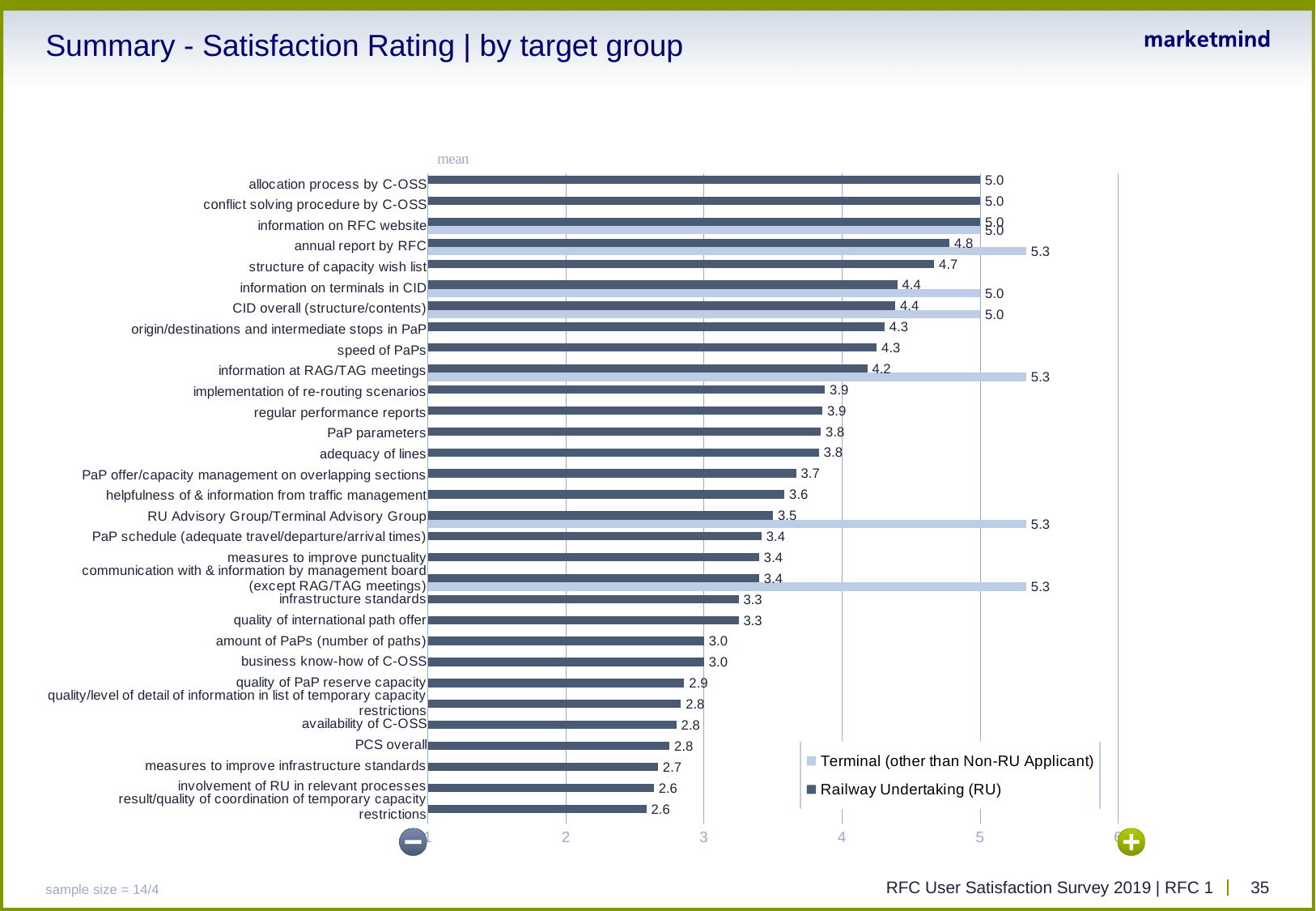
What is the Railway Undertaking (RU) mean rating for 'structure of capacity wish list'? 4.7 What type of chart is shown on the slide? bar chart What is the difference between the Railway Undertaking (RU) ratings for 'allocation process by C-OSS' and 'business know-how of C-OSS'? 2.0 What is the difference between the Terminal and Railway Undertaking (RU) ratings for 'RU Advisory Group/Terminal Advisory Group'? 1.8 How many series does the legend list? 2 What is the Railway Undertaking (RU) mean rating for 'PCS overall'? 2.8 Which is larger: the Railway Undertaking (RU) rating for 'speed of PaPs' or for 'regular performance reports'? speed of PaPs What is the Terminal (other than Non-RU Applicant) mean rating for 'annual report by RFC'? 5.3 Which category has the lowest Railway Undertaking (RU) rating shown at the bottom of the chart? result/quality of coordination of temporary capacity restrictions Is the Railway Undertaking (RU) rating for 'quality of international path offer' greater or less than 4? less What is the Terminal (other than Non-RU Applicant) rating for 'CID overall (structure/contents)'? 5.0 What is the title of the chart slide? Summary - Satisfaction Rating | by target group